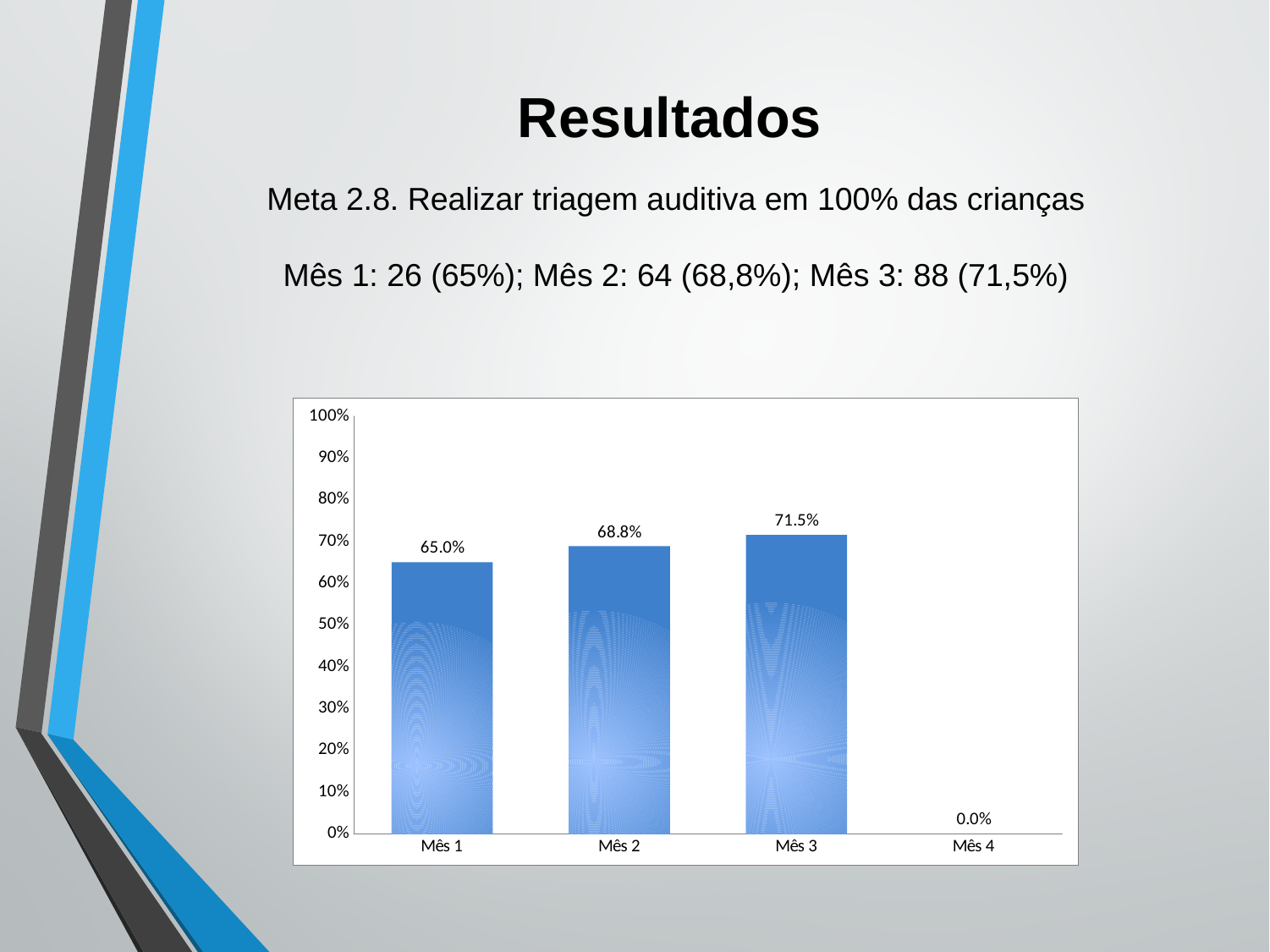
What is the value for Mês 1? 65.0% Which is larger, the value for Mês 2 or the value for Mês 1? Mês 2 Which category has the lowest value? Mês 4 Is the value for Mês 3 greater or less than 70%? greater What is the value for Mês 3? 71.5% What is the difference between the values for Mês 3 and Mês 1? 6.5% Which category has the highest value? Mês 3 Do the values rise or fall from Mês 1 to Mês 3? rise How many categories are shown on the x axis? 4 What is the value for Mês 2? 68.8% What kind of chart is shown? bar chart What is the value for Mês 4? 0.0%